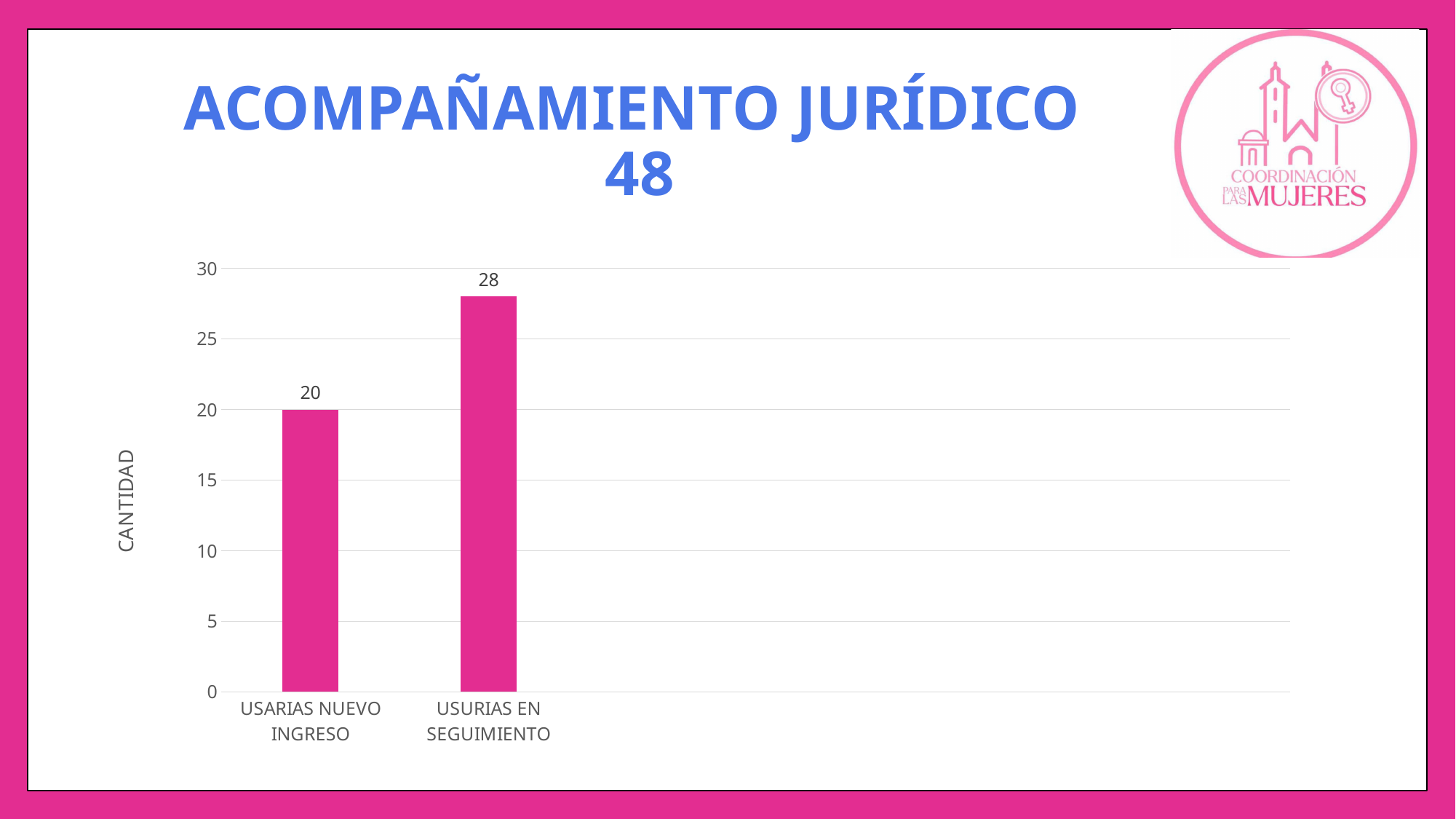
What is the difference between the values for USURIAS EN SEGUIMIENTO and USARIAS NUEVO INGRESO? 8 What is the title shown above the chart? ACOMPAÑAMIENTO JURÍDICO 48 Is the value for USURIAS EN SEGUIMIENTO greater or less than 25? greater Which category has the highest value? USURIAS EN SEGUIMIENTO Is the value for USARIAS NUEVO INGRESO greater or less than 25? less How many categories are shown on the x axis? 2 What is the label of the vertical axis? CANTIDAD Which is larger, the value for USARIAS NUEVO INGRESO or the value for USURIAS EN SEGUIMIENTO? USURIAS EN SEGUIMIENTO Which category has the lowest value? USARIAS NUEVO INGRESO What is the value for USURIAS EN SEGUIMIENTO? 28 What kind of chart is shown on the slide? bar chart What is the value for USARIAS NUEVO INGRESO? 20